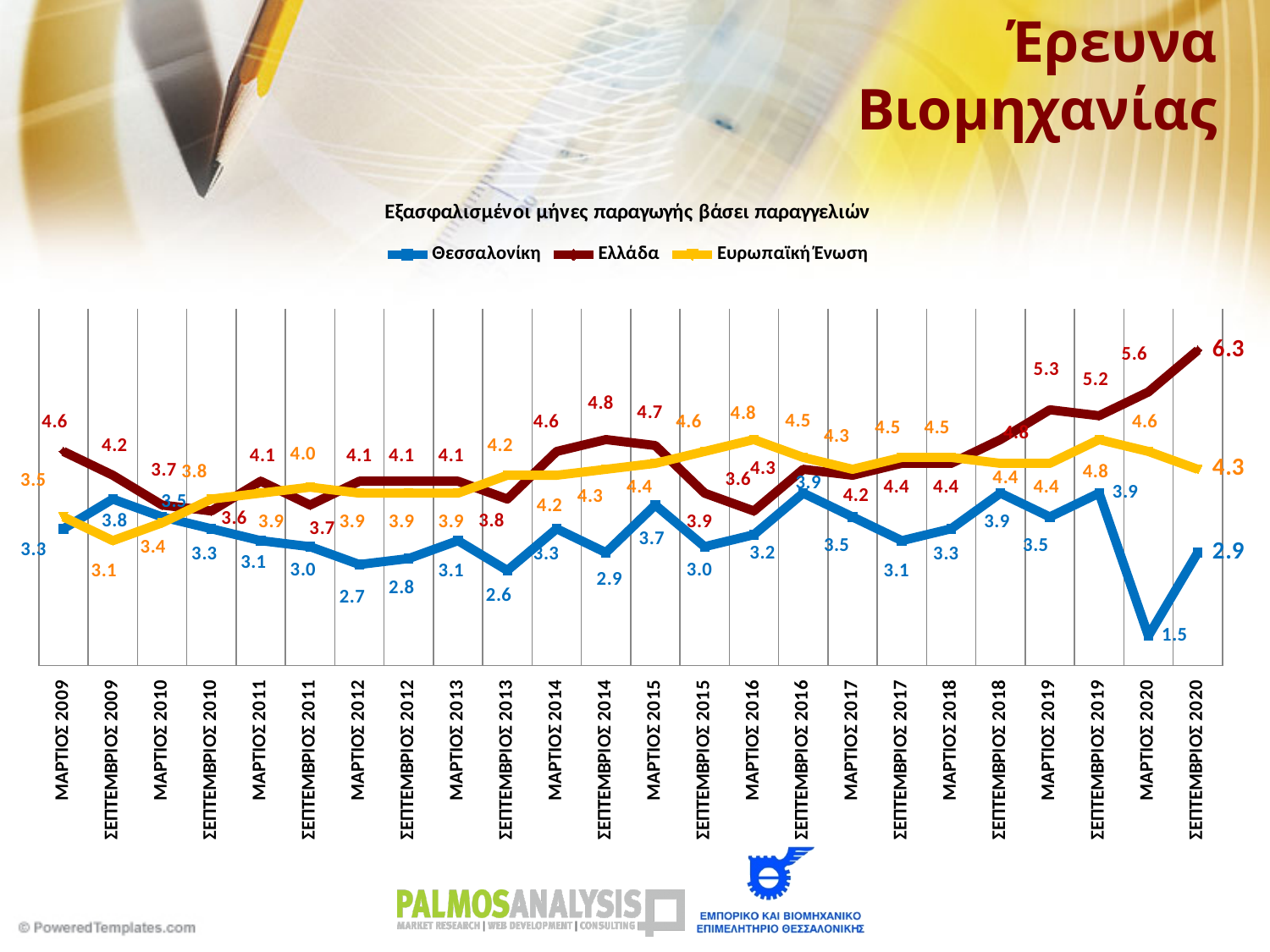
What is the difference between the Ελλάδα and Θεσσαλονίκη values in ΣΕΠΤΕΜΒΡΙΟΣ 2020? 3.4 What is the value for Θεσσαλονίκη in ΜΑΡΤΙΟΣ 2012? 2.7 What is the title of the chart? Εξασφαλισμένοι μήνες παραγωγής βάσει παραγγελιών How many series does the legend list? 3 What is the value for Ελλάδα in ΣΕΠΤΕΜΒΡΙΟΣ 2020? 6.3 What is the value for Θεσσαλονίκη in ΜΑΡΤΙΟΣ 2020? 1.5 What kind of chart is shown on the slide? Line chart In which period does the Θεσσαλονίκη series reach its lowest value? ΜΑΡΤΙΟΣ 2020 How many time points are plotted along the x axis? 24 In ΜΑΡΤΙΟΣ 2020, which series has the larger value, Ελλάδα or Θεσσαλονίκη? Ελλάδα What is the value for Ευρωπαϊκή Ένωση in ΣΕΠΤΕΜΒΡΙΟΣ 2020? 4.3 In which period does the Ελλάδα series reach its highest value? ΣΕΠΤΕΜΒΡΙΟΣ 2020